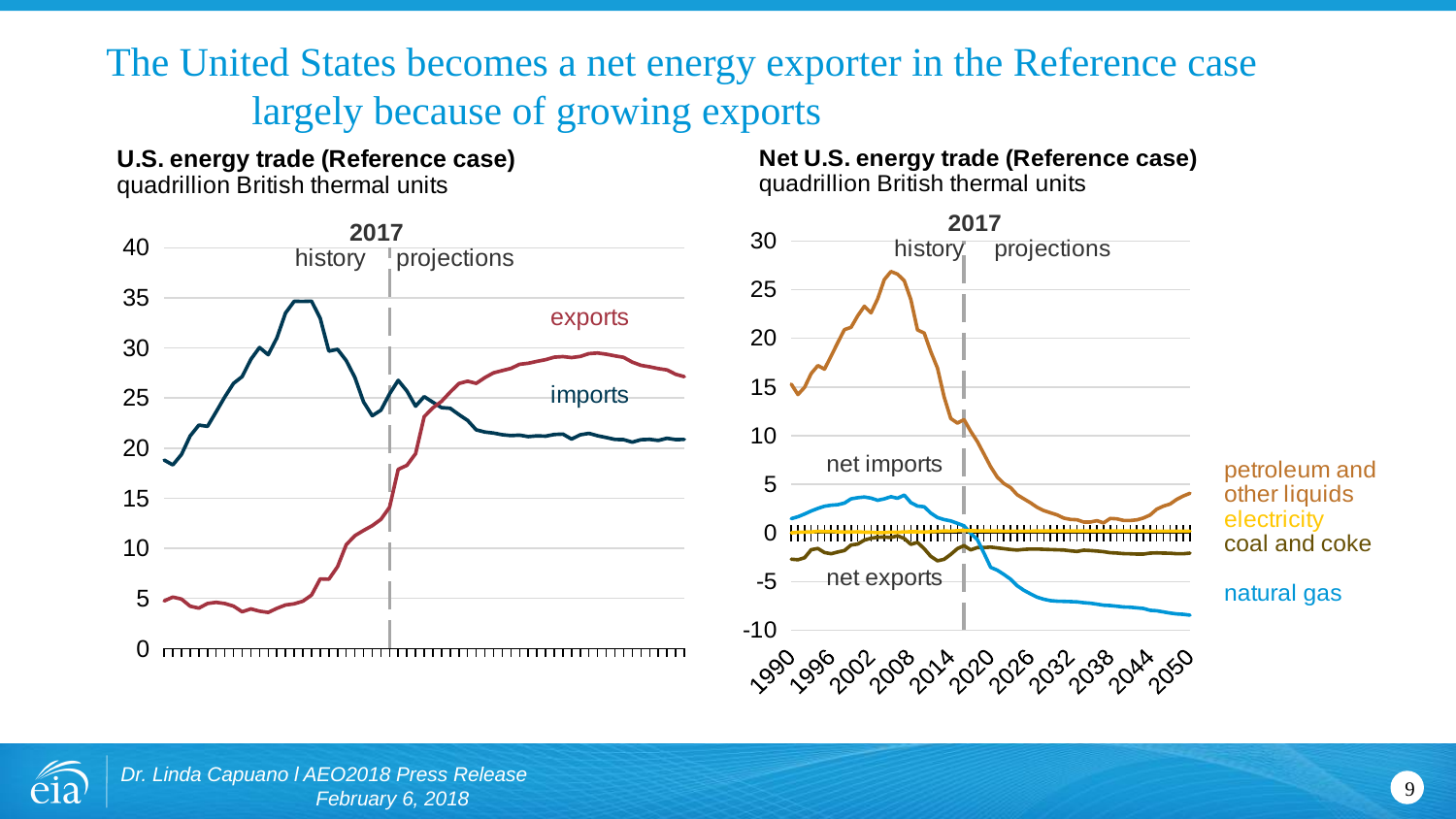
On the left chart, 'U.S. energy trade (Reference case)', is the value for imports at the end of the projection (2050) greater or less than 25? less On the left chart, 'U.S. energy trade (Reference case)', which series is higher at the end of the projection period, exports or imports? exports On the left chart, 'U.S. energy trade (Reference case)', which series is higher in 1990, exports or imports? imports What kind of chart is the left chart, 'U.S. energy trade (Reference case)'? line chart On the right chart, 'Net U.S. energy trade (Reference case)', does the natural gas line rise or fall over the projection period? fall How many series are plotted on the right chart, 'Net U.S. energy trade (Reference case)'? 4 What year does the dashed vertical line separating history from projections mark on both charts? 2017 How many series are plotted on the left chart, 'U.S. energy trade (Reference case)'? 2 On the right chart, 'Net U.S. energy trade (Reference case)', is the peak value for petroleum and other liquids greater or less than 25? greater On the left chart, 'U.S. energy trade (Reference case)', is the value for exports at the end of the projection (2050) greater or less than 25? greater